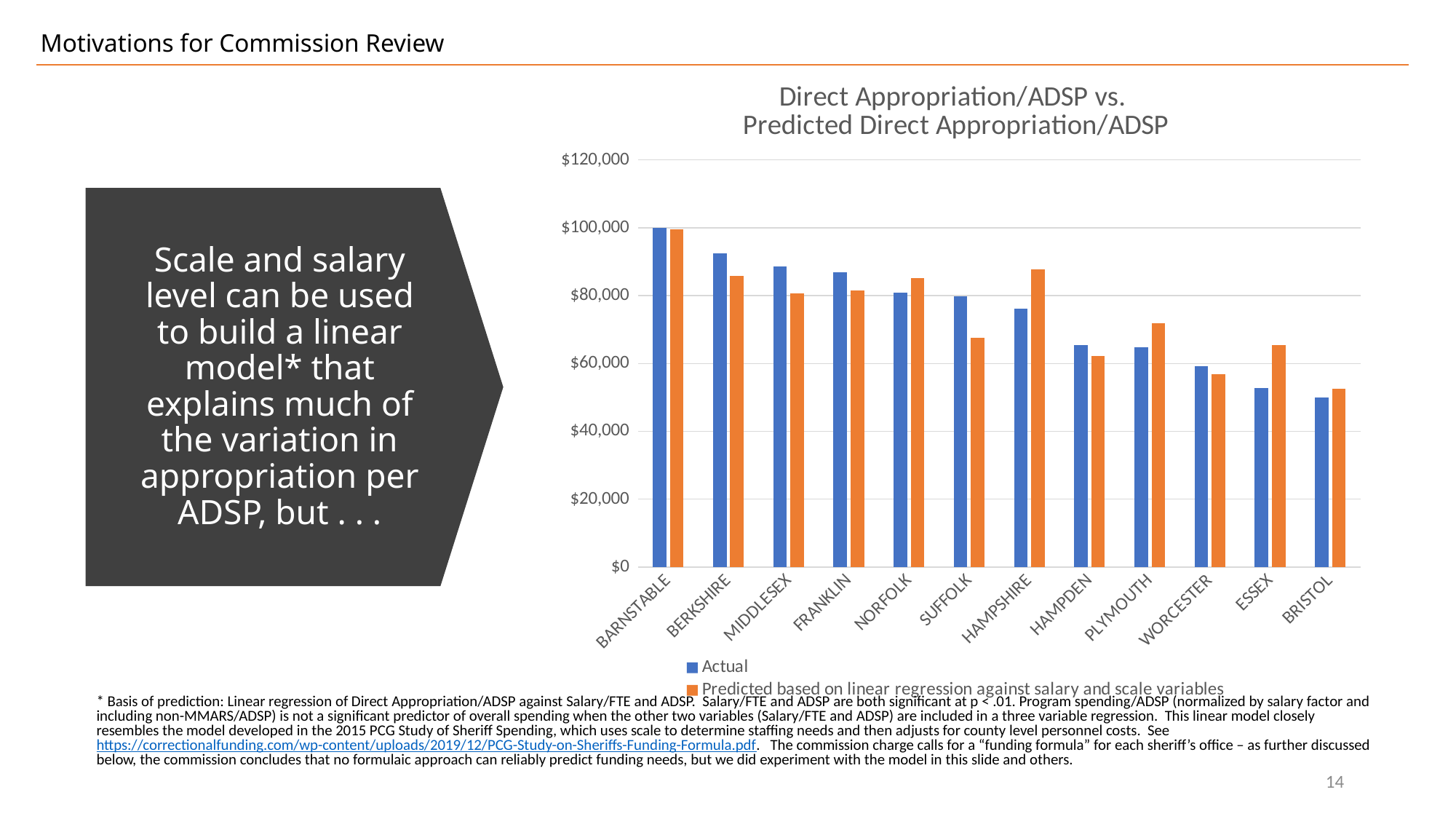
For Suffolk, which is larger: the Actual value or the Predicted value? Actual How many counties are shown on the x axis of the chart? 12 What type of chart is shown on the slide? Bar chart Which county has the lowest Predicted value? Bristol Is the Predicted value for Suffolk greater or less than $80,000? less Is the Predicted value for Hampshire greater or less than $80,000? greater Which county has the lowest Actual value? Bristol For Hampshire, which is larger: the Actual value or the Predicted value? Predicted Which county has the highest Actual value? Barnstable How many series does the chart's legend list? 2 Is the Actual value for Essex greater or less than $40,000? greater Do the Actual values generally rise or fall moving from left to right along the x axis? Fall